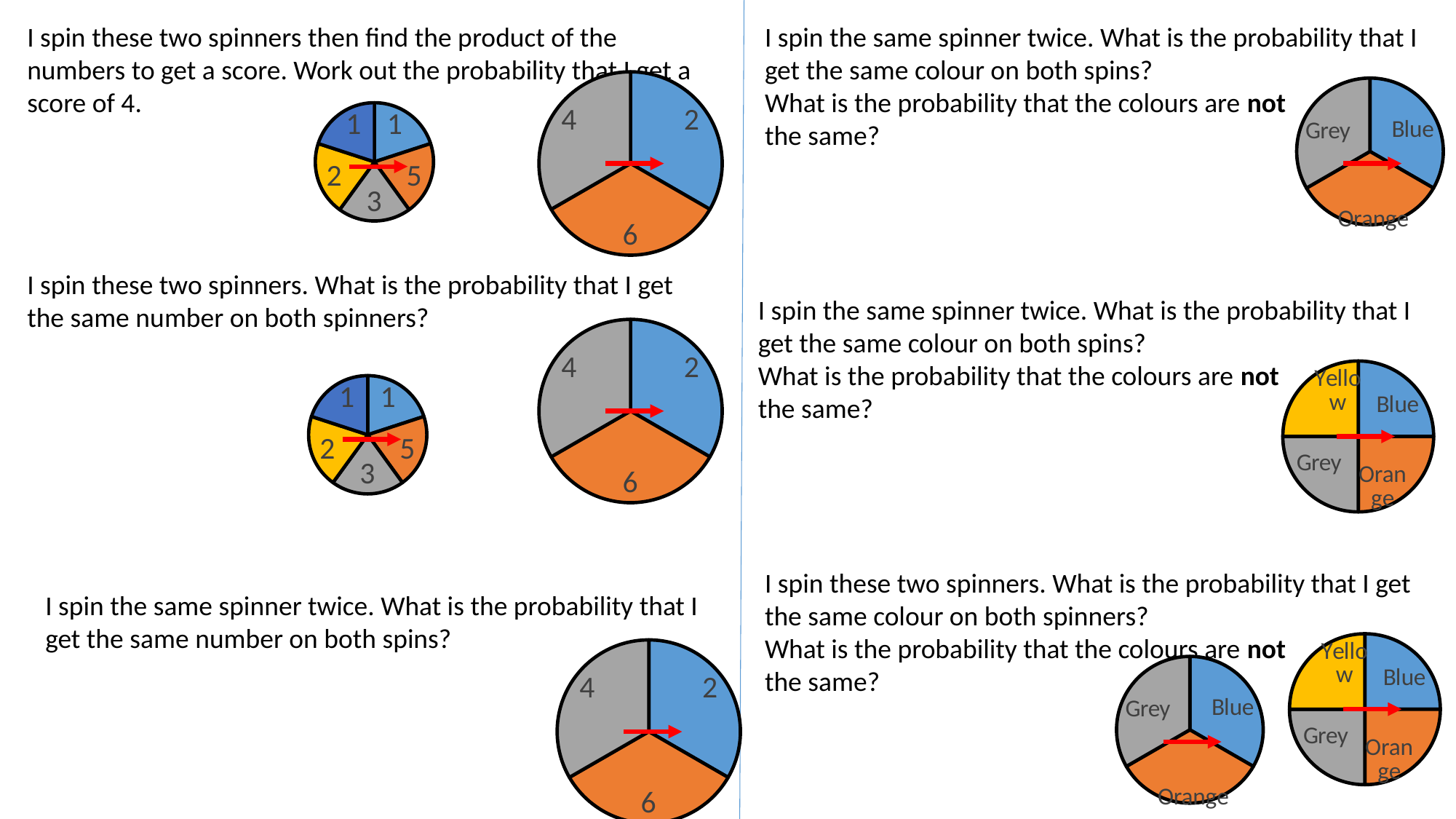
On the large spinner in the top-left question, what number is in the orange section? 6 How many spinners are shown in the bottom-right question? 2 On the small five-section spinner in the top-left question, which number appears twice? 1 How many sections does the large spinner in the top-left question have? 3 How many sections does the spinner in the middle-right question have? 4 On the large spinner in the top-left question, what number is in the blue section? 2 What are the three colour labels on the spinner in the top-right question? Grey, Blue, Orange On the small five-section spinner in the top-left question, what number is in the yellow section? 2 On the large spinner in the top-left question, what number is in the grey section? 4 What are the four colour labels on the spinner in the middle-right question? Yellow, Blue, Grey, Orange